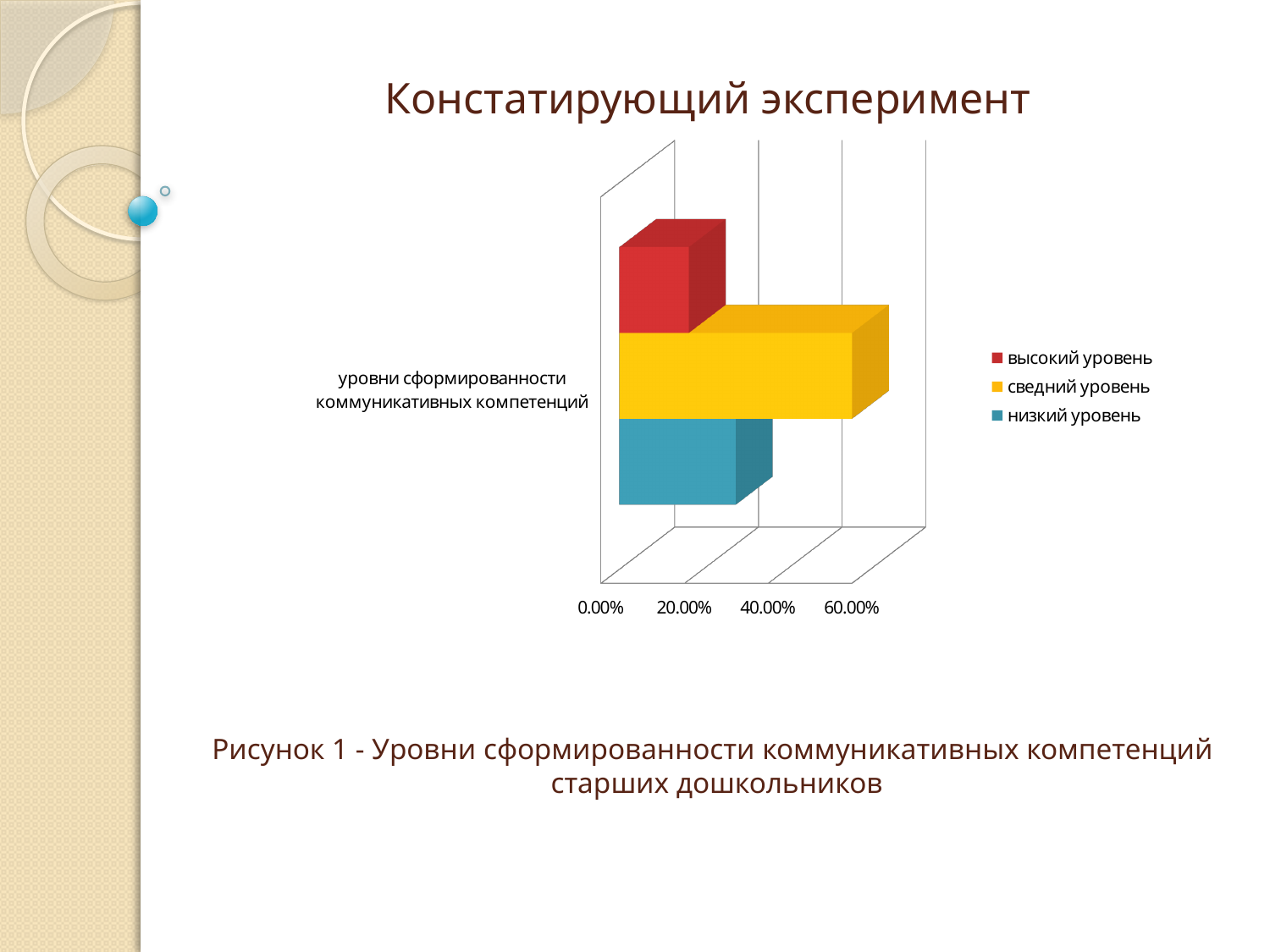
Is the value for высокий уровень greater or less than 40.00%? less Which is larger, the value for низкий уровень or the value for высокий уровень? низкий уровень How many categories are plotted on the chart? 1 How many series does the legend list? 3 Is the value for низкий уровень greater or less than 20.00%? greater Is the value for сведний уровень greater or less than 40.00%? greater What colour represents сведний уровень in the legend? yellow Which series has the lowest value? высокий уровень What is the category label shown on the chart's vertical axis? уровни сформированности коммуникативных компетенций Which series has the highest value? сведний уровень What kind of chart is shown on the slide? bar chart